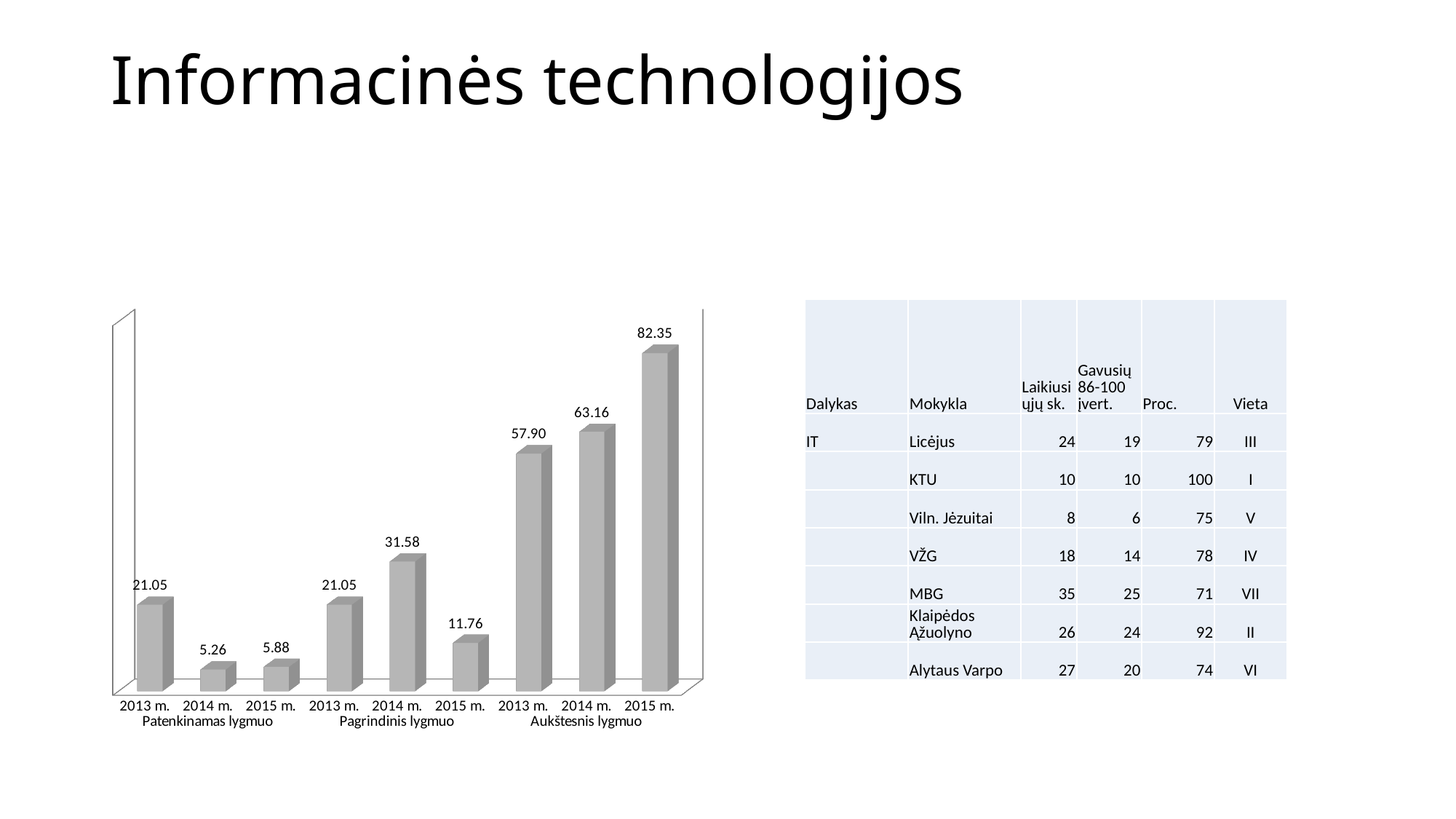
What is the value for 2013 m. in the Aukštesnis lygmuo group? 57.90 What is the value for 2015 m. in the Aukštesnis lygmuo group? 82.35 What kind of chart is shown on the slide? Bar chart What is the value for 2014 m. in the Pagrindinis lygmuo group? 31.58 Which bar has the lowest value in the chart? 2014 m., Patenkinamas lygmuo What is the difference between the 2014 m. and 2015 m. values in the Pagrindinis lygmuo group? 19.82 What is the value for 2014 m. in the Patenkinamas lygmuo group? 5.26 Which bar has the highest value in the chart? 2015 m., Aukštesnis lygmuo What is the difference between the 2015 m. and 2013 m. values in the Aukštesnis lygmuo group? 24.45 Which is larger: the 2013 m. value in the Pagrindinis lygmuo group or the 2015 m. value in the Pagrindinis lygmuo group? 2013 m. (21.05) Do the values in the Aukštesnis lygmuo group rise or fall from 2013 m. to 2015 m.? Rise How many bars are plotted in the chart? 9